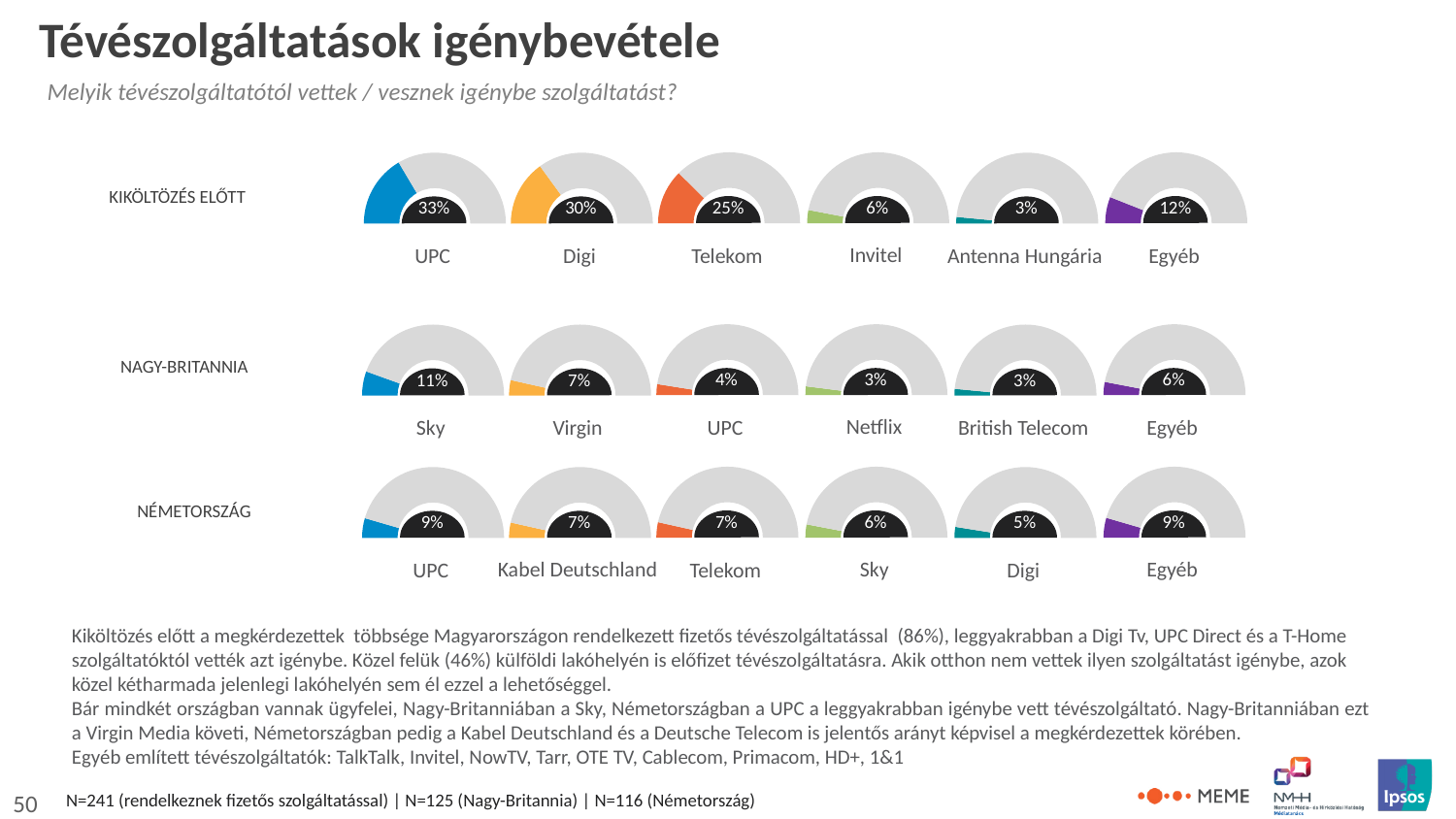
In the KIKÖLTÖZÉS ELŐTT row, what is the value shown for Antenna Hungária? 3% In the NAGY-BRITANNIA row, what is the difference between the values for Sky and Virgin? 4% In the KIKÖLTÖZÉS ELŐTT row, which provider has the highest value? UPC What kind of chart is used to show each provider's value on the slide? Gauge (semi-donut) chart In the KIKÖLTÖZÉS ELŐTT row, what is the value shown for UPC? 33% In the NAGY-BRITANNIA row, which is larger, the value for UPC or the value for Egyéb? Egyéb In the NÉMETORSZÁG row, which provider has the lowest value? Digi How many providers are shown in the NÉMETORSZÁG row? 6 In the NÉMETORSZÁG row, what is the value shown for Kabel Deutschland? 7% In the KIKÖLTÖZÉS ELŐTT row, what is the difference between the values for UPC and Telekom? 8% What is the title of the slide? Tévészolgáltatások igénybevétele In the NAGY-BRITANNIA row, what is the value shown for Sky? 11%